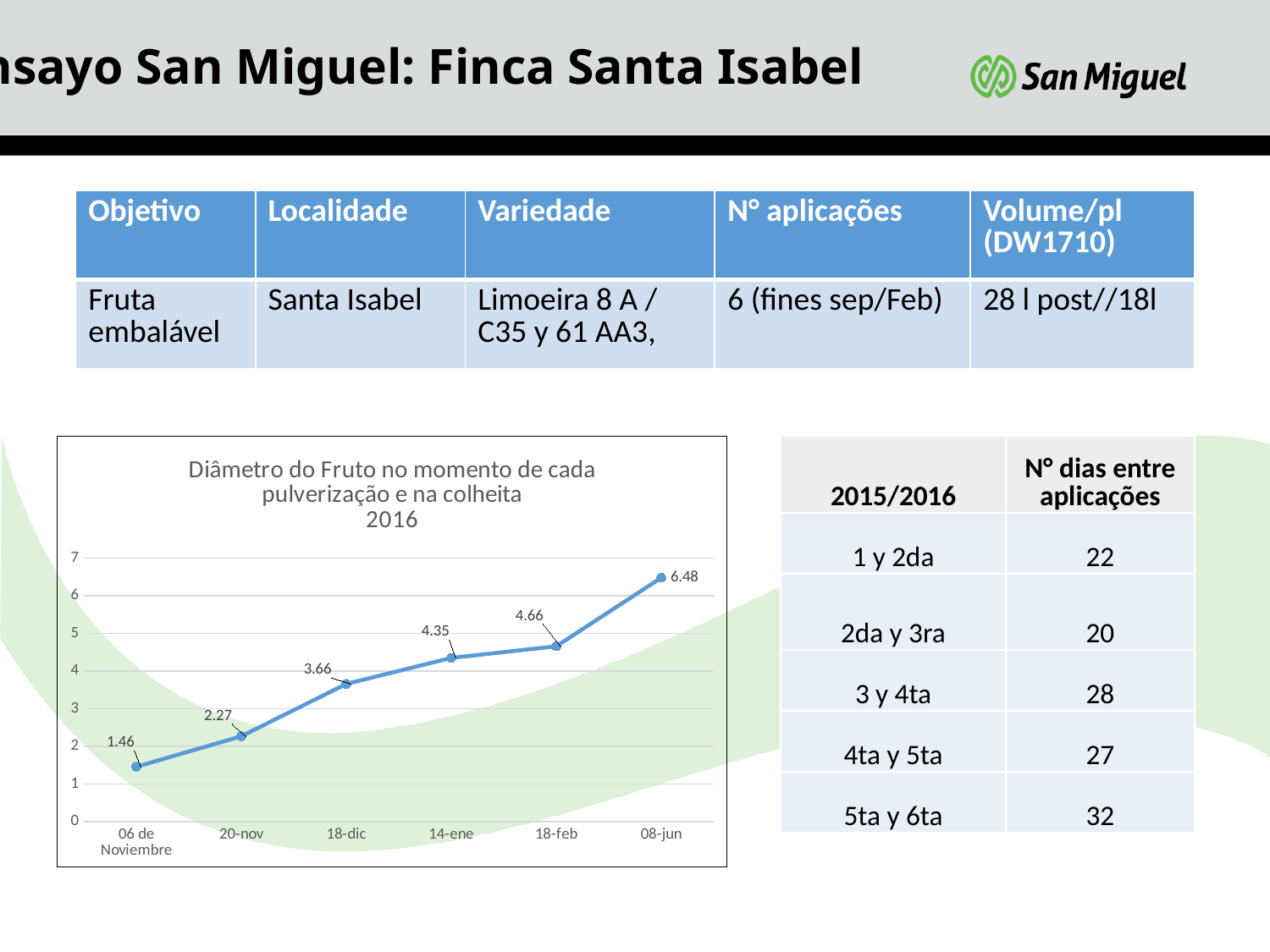
Which date has the lowest fruit diameter value? 06 de Noviembre What is the difference between the values at 08-jun and 18-feb? 1.82 What type of chart is shown on the slide? line chart How many data points are plotted on the chart? 6 Do the values rise or fall from 06 de Noviembre to 08-jun? rise What is the title of the chart? Diâmetro do Fruto no momento de cada pulverização e na colheita 2016 What is the fruit diameter value at 20-nov? 2.27 What is the fruit diameter value at 14-ene? 4.35 Which date has the highest fruit diameter value? 08-jun What is the fruit diameter value at 08-jun? 6.48 What is the fruit diameter value at 18-dic? 3.66 Which is larger, the value at 18-dic or the value at 20-nov? 18-dic